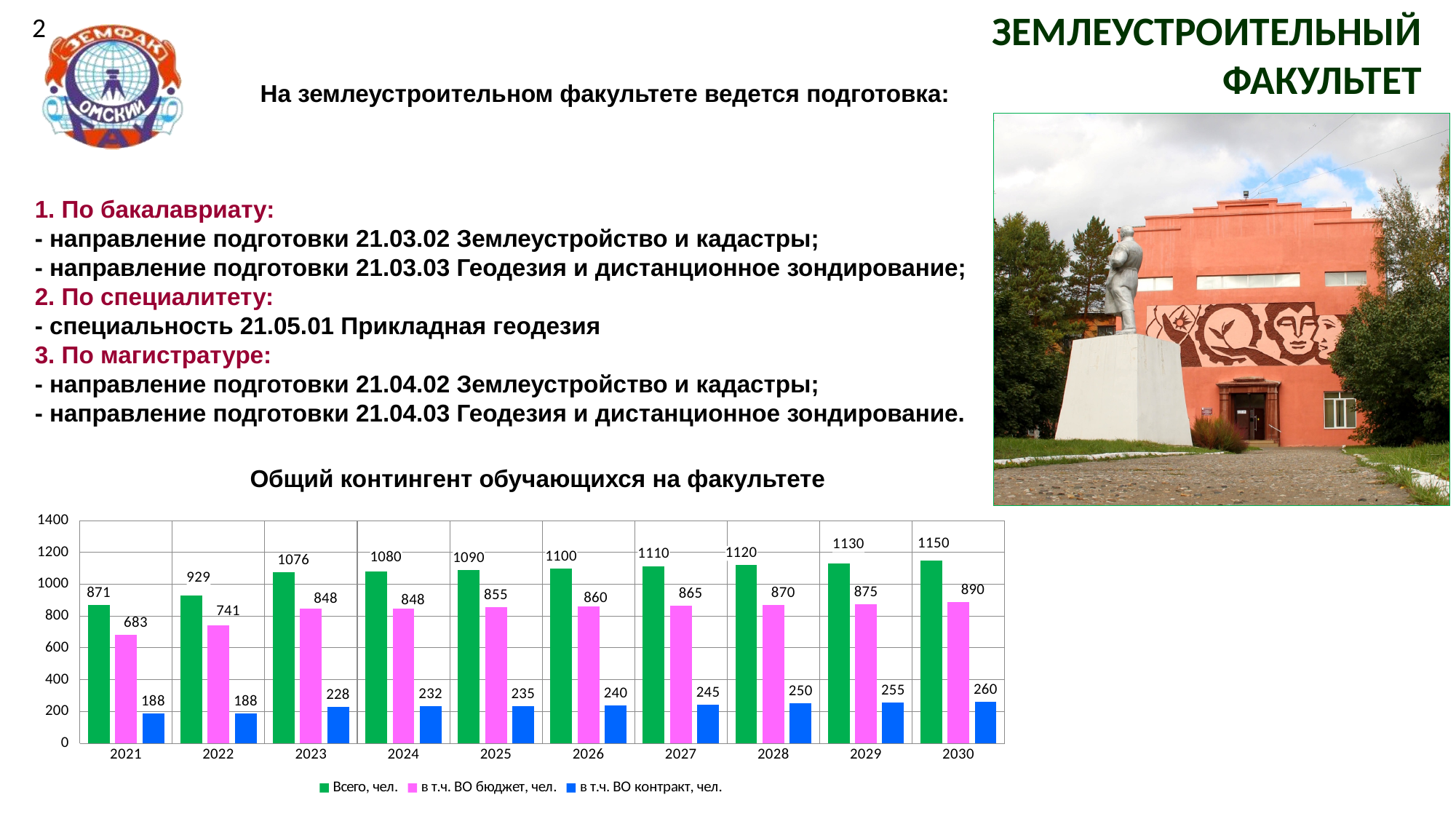
What type of chart is shown on the slide? bar chart Is the value of 'Всего, чел.' for 2022 greater or less than 1000? less How many years are shown on the x axis of the chart? 10 In which year is 'Всего, чел.' highest? 2030 What is the value of 'в т.ч. ВО контракт, чел.' for 2030? 260 Does 'в т.ч. ВО контракт, чел.' rise or fall from 2023 to 2030? rise In which year is 'в т.ч. ВО бюджет, чел.' lowest? 2021 What is the value of 'Всего, чел.' for 2021? 871 How many series does the chart legend list? 3 What is the difference between 'Всего, чел.' in 2030 and in 2021? 279 What is the value of 'в т.ч. ВО бюджет, чел.' for 2025? 855 Which is larger: 'в т.ч. ВО контракт, чел.' in 2023 or in 2022? 2023